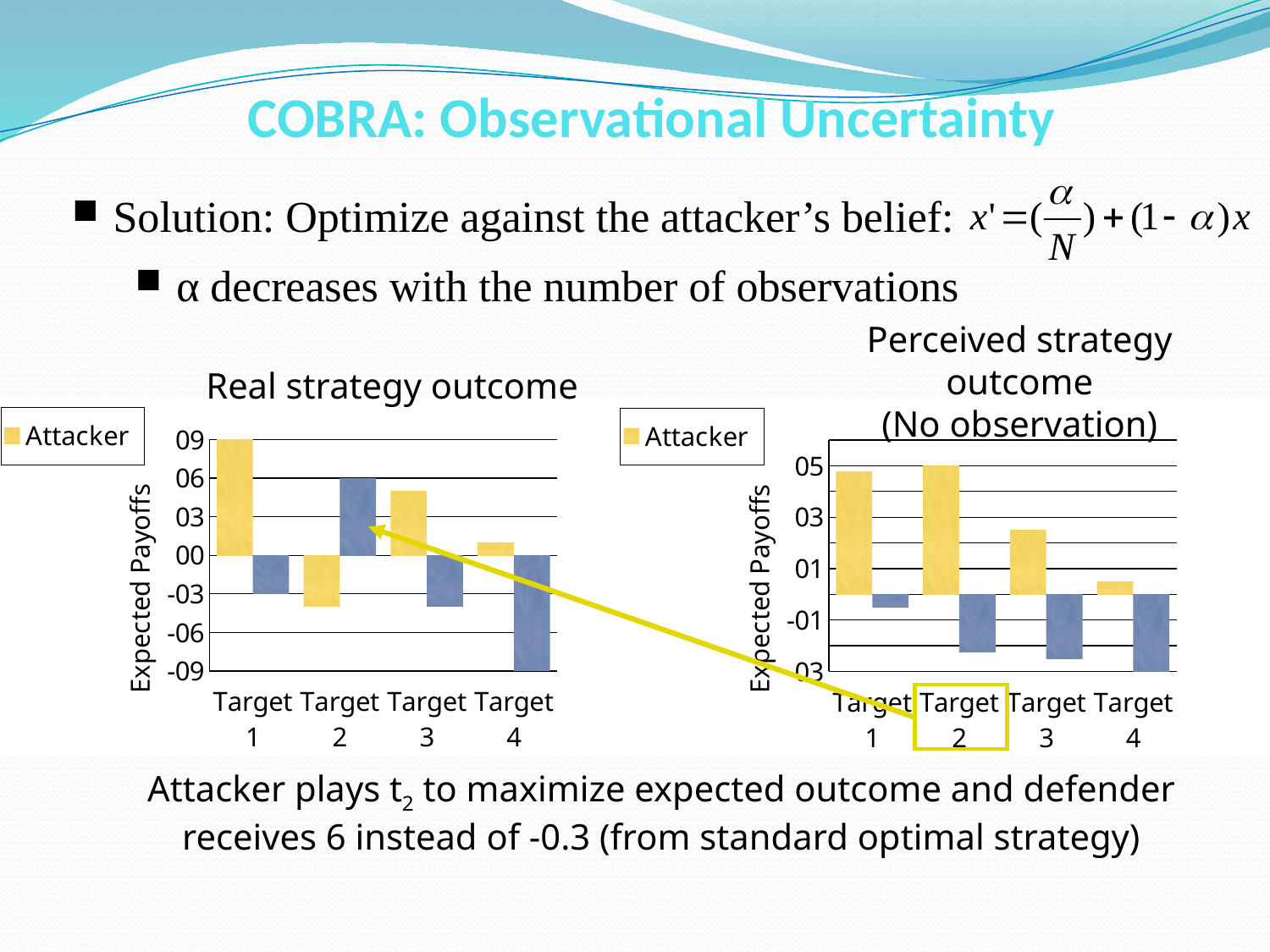
In the 'Real strategy outcome' chart, which is larger, the Attacker value for Target 3 or for Target 4? Target 3 In the 'Perceived strategy outcome (No observation)' chart, do the Attacker values rise or fall from Target 2 to Target 4? fall How many target categories are shown on the x axis of the 'Real strategy outcome' chart? 4 In the 'Perceived strategy outcome (No observation)' chart, is the Attacker value for Target 4 greater or less than 01? less In the 'Real strategy outcome' chart, is the Attacker value for Target 2 greater or less than 00? less In the 'Real strategy outcome' chart, which target has the lowest value for the blue series? Target 4 In the 'Real strategy outcome' chart, which target has the highest Attacker value? Target 1 What is the title of the chart on the left of the slide? Real strategy outcome In the 'Perceived strategy outcome (No observation)' chart, is the Attacker value for Target 3 greater or less than 03? less What kind of chart is the 'Real strategy outcome' chart? bar chart